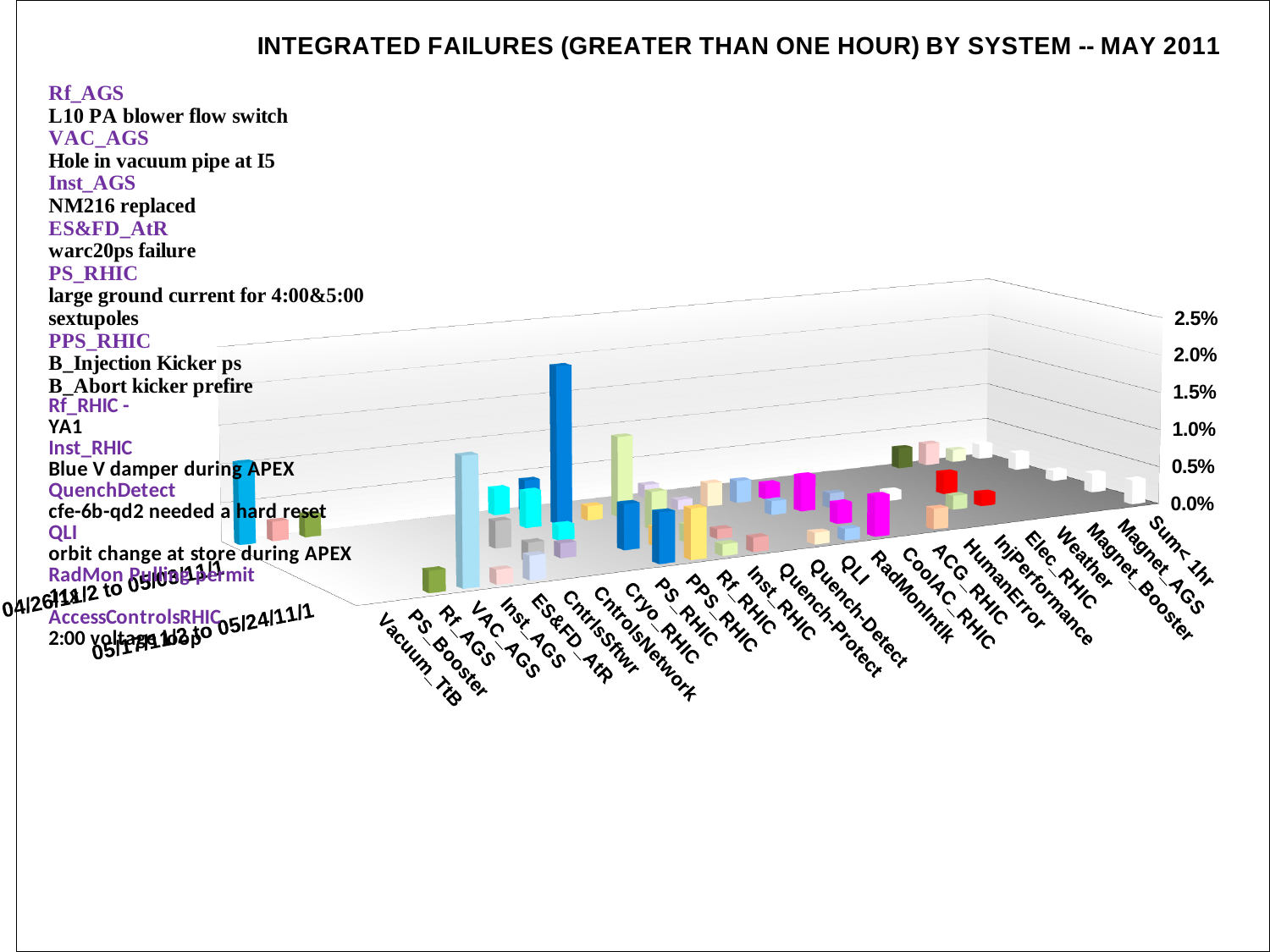
What is the title of the chart? INTEGRATED FAILURES (GREATER THAN ONE HOUR) BY SYSTEM -- MAY 2011 How many system categories are listed along the x axis of the chart? 26 What is the highest tick value shown on the chart's vertical axis? 2.5% What kind of chart is shown on the slide? bar chart Is the tallest bar in the chart greater or less than 1.0%? greater